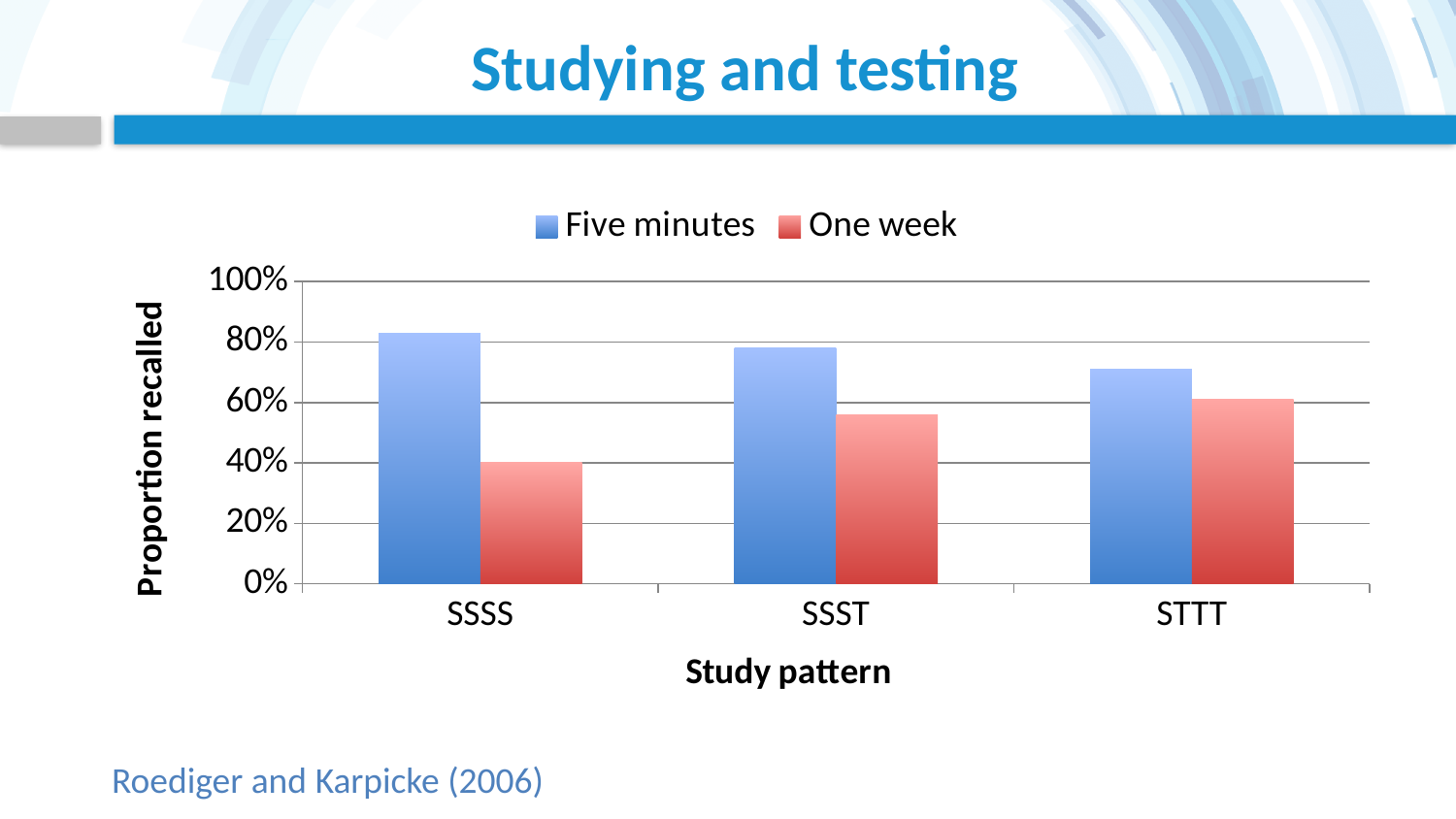
How many series does the legend list? 2 Which study pattern has the highest Five minutes value? SSSS Which study pattern has the lowest One week value? SSSS For SSSS, which is larger: the Five minutes value or the One week value? Five minutes Is the Five minutes value for SSSS greater or less than 80%? greater What is the label of the y axis? Proportion recalled Do the Five minutes values rise or fall from SSSS to STTT along the x axis? fall How many study patterns are shown on the x axis? 3 Which study pattern has the highest One week value? STTT Is the One week value for SSST greater or less than 60%? less What kind of chart is shown on the slide? bar chart